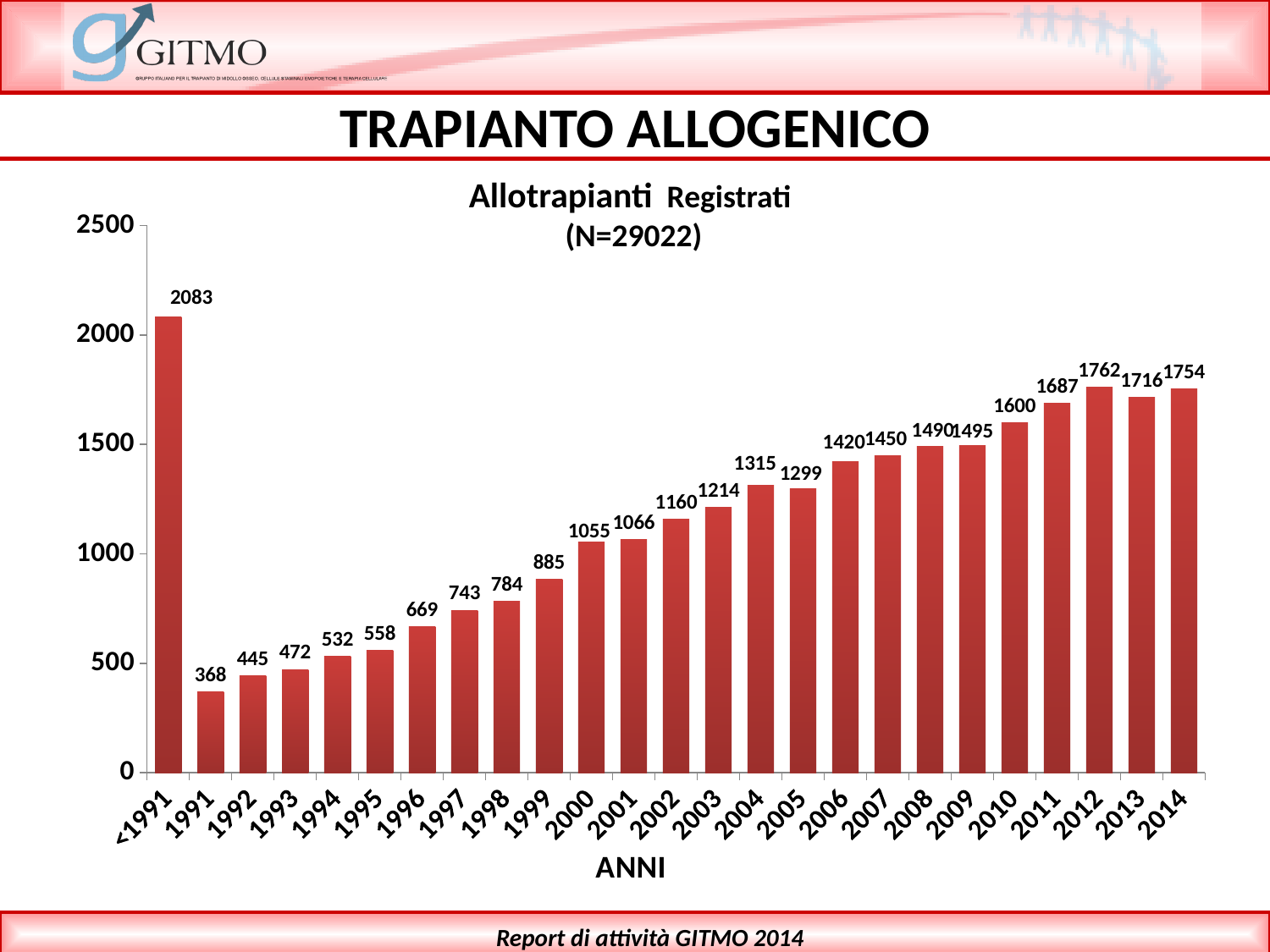
What kind of chart is shown on the slide? bar chart What is the value for 1999? 885 What is the difference between the values for 2012 and 2011? 75 What is the title of the x axis? ANNI What is the value for 2005? 1299 Is the value for 2010 greater or less than 1500? greater Which is larger, the value for 2004 or the value for 2005? 2004 Which category has the highest value? <1991 What is the difference between the values for 2014 and 2013? 38 Which year has the lowest value? 1991 How many categories are shown on the x axis? 25 What is the value for 2014 in the Allotrapianti Registrati chart? 1754